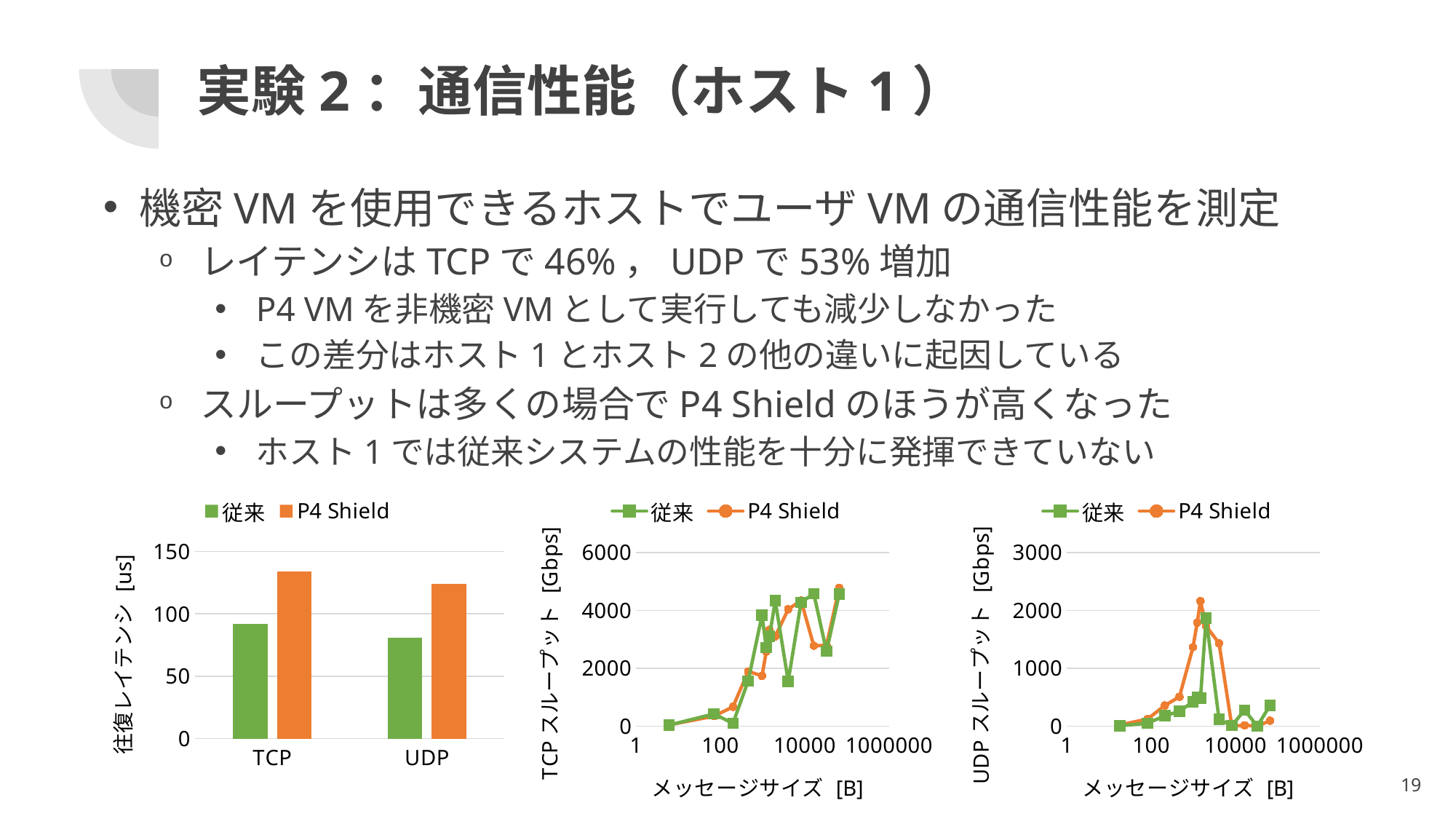
In the 往復レイテンシ bar chart, which series has the larger value at TCP, 従来 or P4 Shield? P4 Shield In the 往復レイテンシ bar chart, which series has the larger value at UDP, 従来 or P4 Shield? P4 Shield What kind of chart is the TCP スループット chart? line chart In the 往復レイテンシ bar chart, how many categories are shown on the x axis? 2 In the 往復レイテンシ bar chart, is the value for P4 Shield at UDP greater or less than 100? greater In the TCP スループット chart, is the highest value reached by P4 Shield greater or less than 4000? greater In the 往復レイテンシ bar chart, is the value for P4 Shield at TCP greater or less than 100? greater In the 往復レイテンシ bar chart, how many series does the legend list? 2 What kind of chart is the leftmost chart (往復レイテンシ)? bar chart What is the x-axis label of the UDP スループット chart? メッセージサイズ [B]